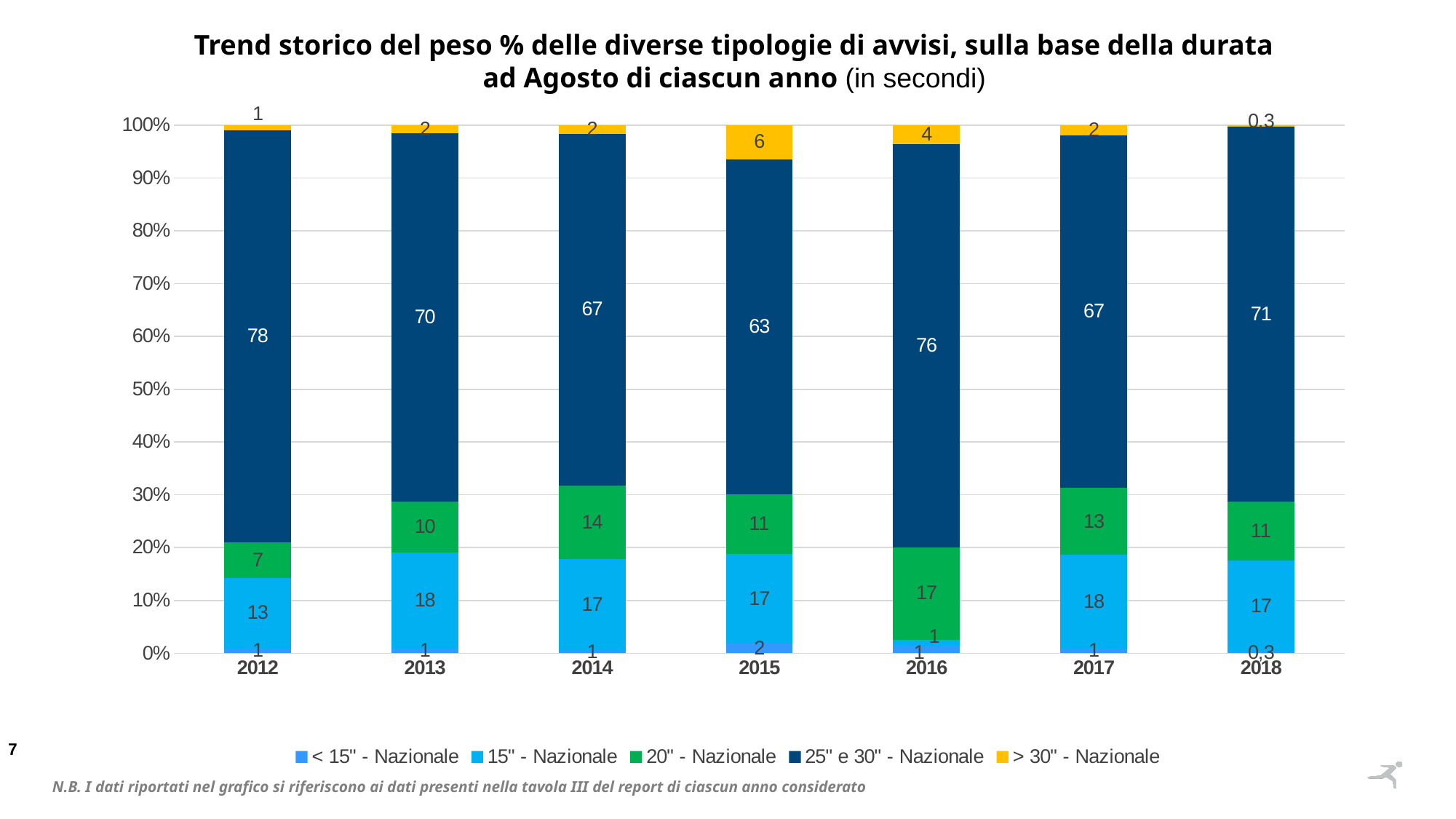
How many years are shown on the x axis? 7 What is the value for the "> 30'' - Nazionale" series in 2018? 0.3 What is the value for the "> 30'' - Nazionale" series in 2015? 6 What kind of chart is shown on the slide? Stacked bar chart What is the difference between the "25'' e 30'' - Nazionale" values in 2012 and 2015? 15 What is the value for the "25'' e 30'' - Nazionale" series in 2012? 78 What is the value for the "15'' - Nazionale" series in 2018? 17 In which year is the "25'' e 30'' - Nazionale" value the lowest? 2015 In which year is the "25'' e 30'' - Nazionale" value the highest? 2012 What is the value for the "20'' - Nazionale" series in 2014? 14 How many series does the legend list? 5 Which is larger: the "20'' - Nazionale" value in 2016 or in 2017? 2016